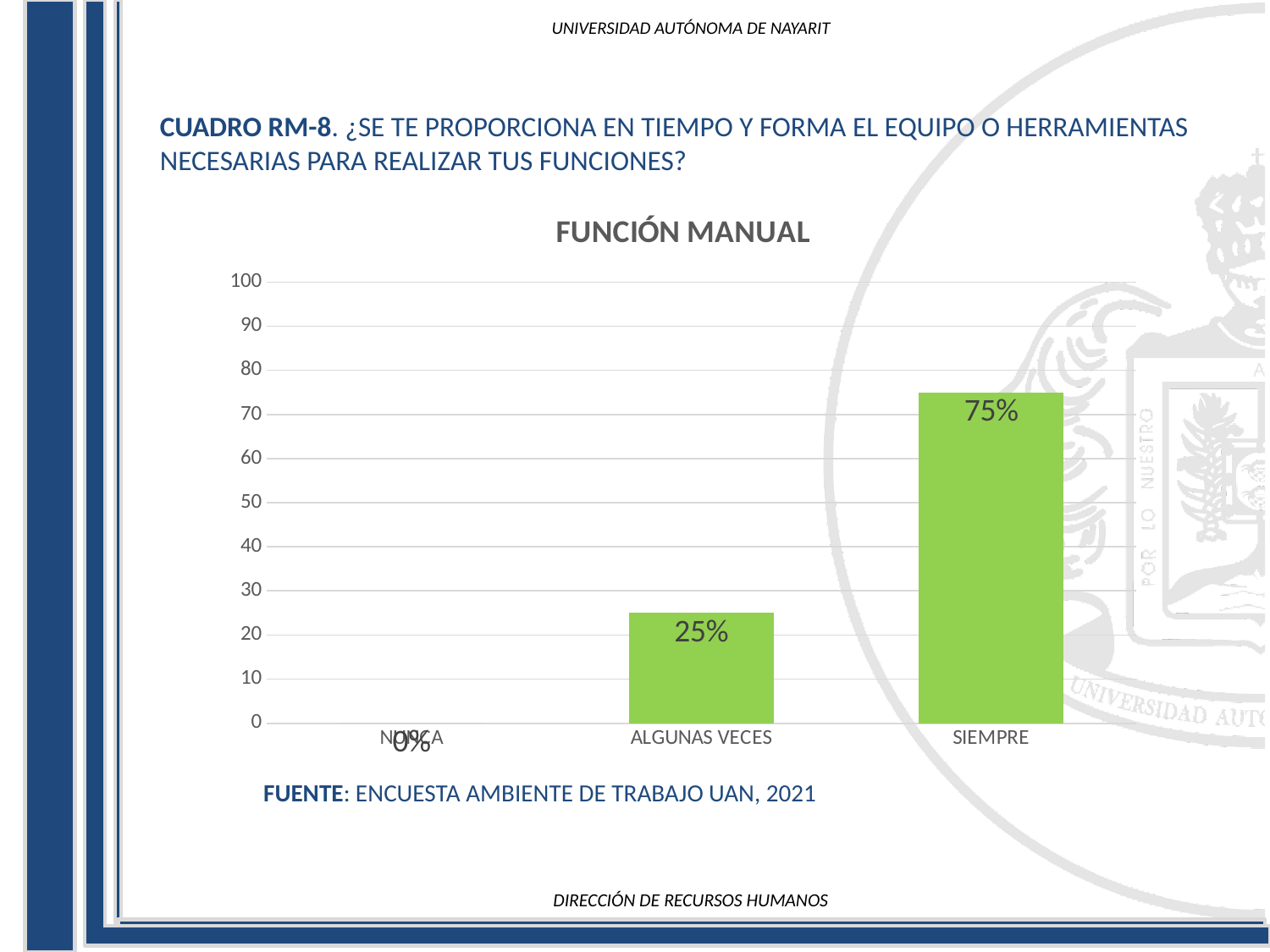
What is the title of the chart? FUNCIÓN MANUAL Is the value for ALGUNAS VECES greater or less than 30? less How many categories are shown on the x axis? 3 What is the difference between the values for SIEMPRE and ALGUNAS VECES? 50% Which is larger, the value for ALGUNAS VECES or the value for SIEMPRE? SIEMPRE What is the value for SIEMPRE? 75% Which category has the highest value? SIEMPRE Which category has the lowest value? NUNCA What is the value for NUNCA? 0% What kind of chart is shown? bar chart What is the value for ALGUNAS VECES? 25% Is the value for SIEMPRE greater or less than 50? greater